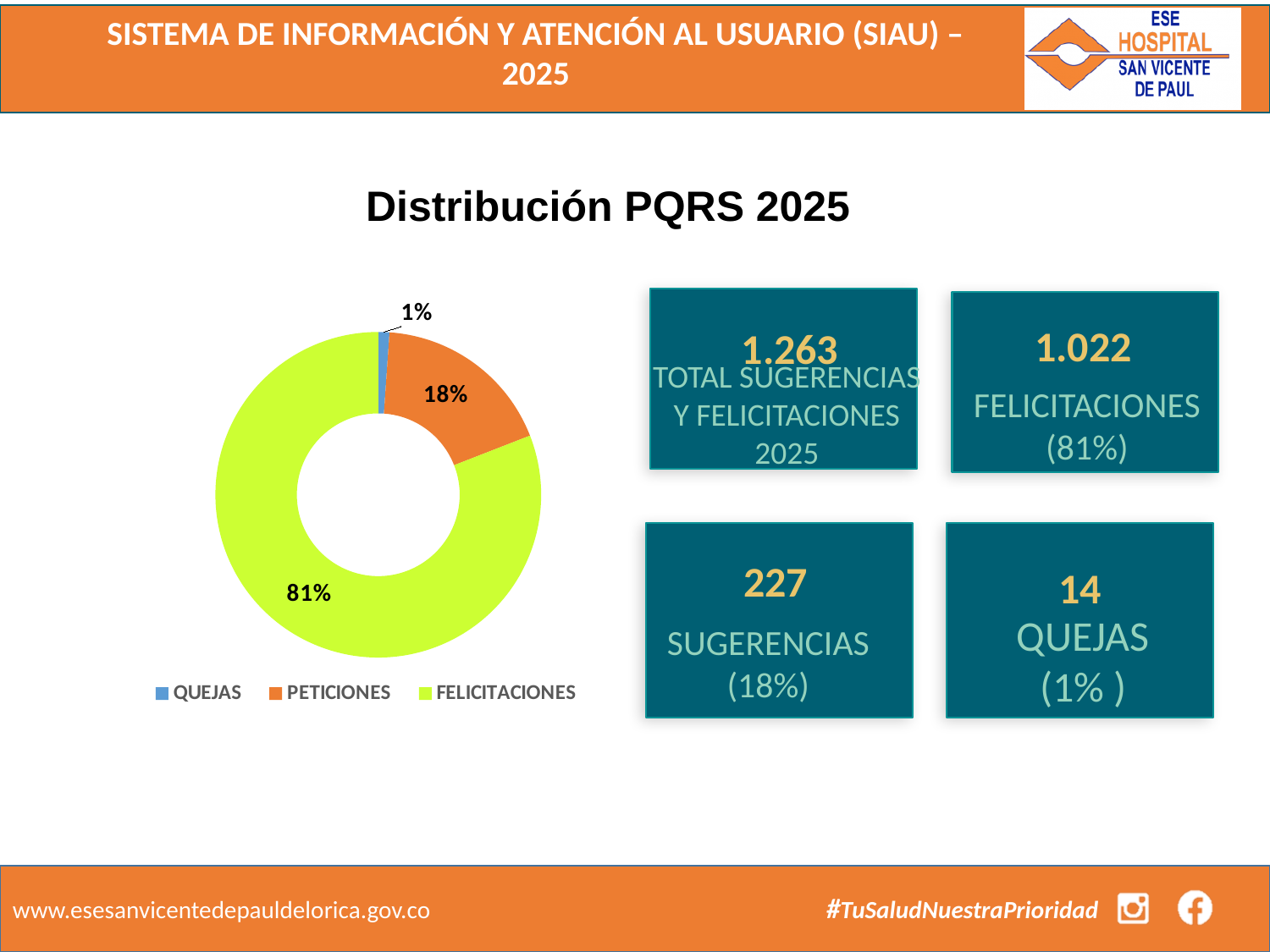
By how many percentage points does FELICITACIONES exceed PETICIONES in the Distribución PQRS 2025 chart? 63 percentage points What share of the doughnut does QUEJAS take in the Distribución PQRS 2025 chart? 1% How many entries does the legend of the Distribución PQRS 2025 chart list? 3 Which slice is larger in the Distribución PQRS 2025 chart, PETICIONES or QUEJAS? PETICIONES Which category has the largest slice in the Distribución PQRS 2025 chart? FELICITACIONES How many categories are shown in the Distribución PQRS 2025 chart? 3 What colour represents PETICIONES in the Distribución PQRS 2025 chart? Orange What is the title of the chart on the slide? Distribución PQRS 2025 What percentage does the PETICIONES slice show in the Distribución PQRS 2025 chart? 18% What percentage does the FELICITACIONES slice show in the Distribución PQRS 2025 chart? 81% What kind of chart is used for Distribución PQRS 2025? Doughnut chart Which category has the smallest slice in the Distribución PQRS 2025 chart? QUEJAS